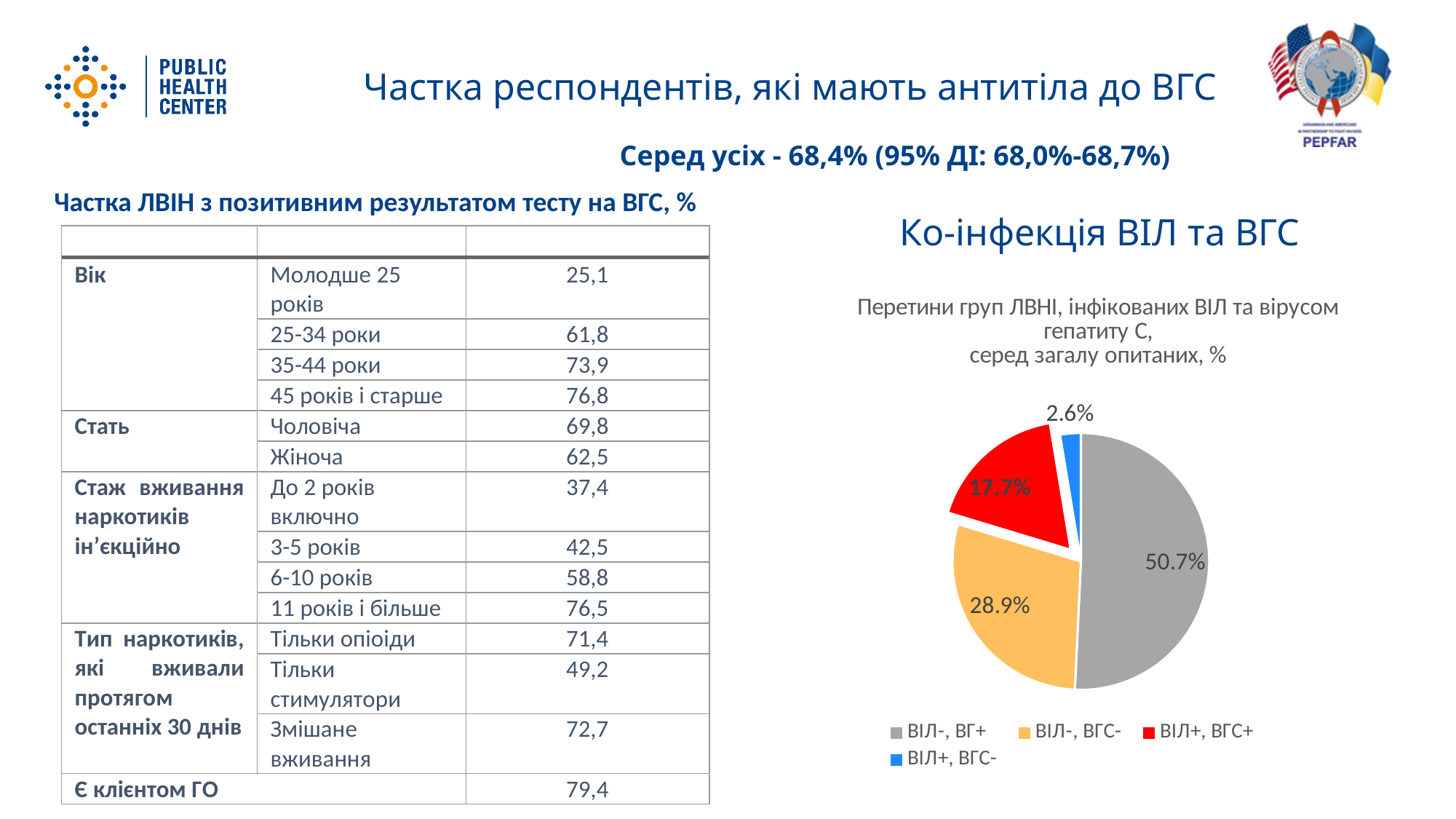
In the pie chart, what is the value for the "ВІЛ+, ВГС+" slice? 17.7% Which slice of the pie chart is the largest? ВІЛ-, ВГ+ What colour is the "ВІЛ+, ВГС+" slice in the pie chart? red Which slice of the pie chart is the smallest? ВІЛ+, ВГС- In the pie chart, what is the value for the "ВІЛ-, ВГС-" slice? 28.9% In the pie chart, what is the value for the "ВІЛ-, ВГ+" slice? 50.7% How many entries does the pie chart legend list? 4 In the pie chart, what is the difference between the "ВІЛ-, ВГС-" slice and the "ВІЛ+, ВГС+" slice? 11.2% In the pie chart, which is larger: the "ВІЛ+, ВГС+" slice or the "ВІЛ-, ВГС-" slice? ВІЛ-, ВГС- What kind of chart is shown on the slide? pie chart In the pie chart, what is the value for the "ВІЛ+, ВГС-" slice? 2.6% How many slices does the pie chart have? 4